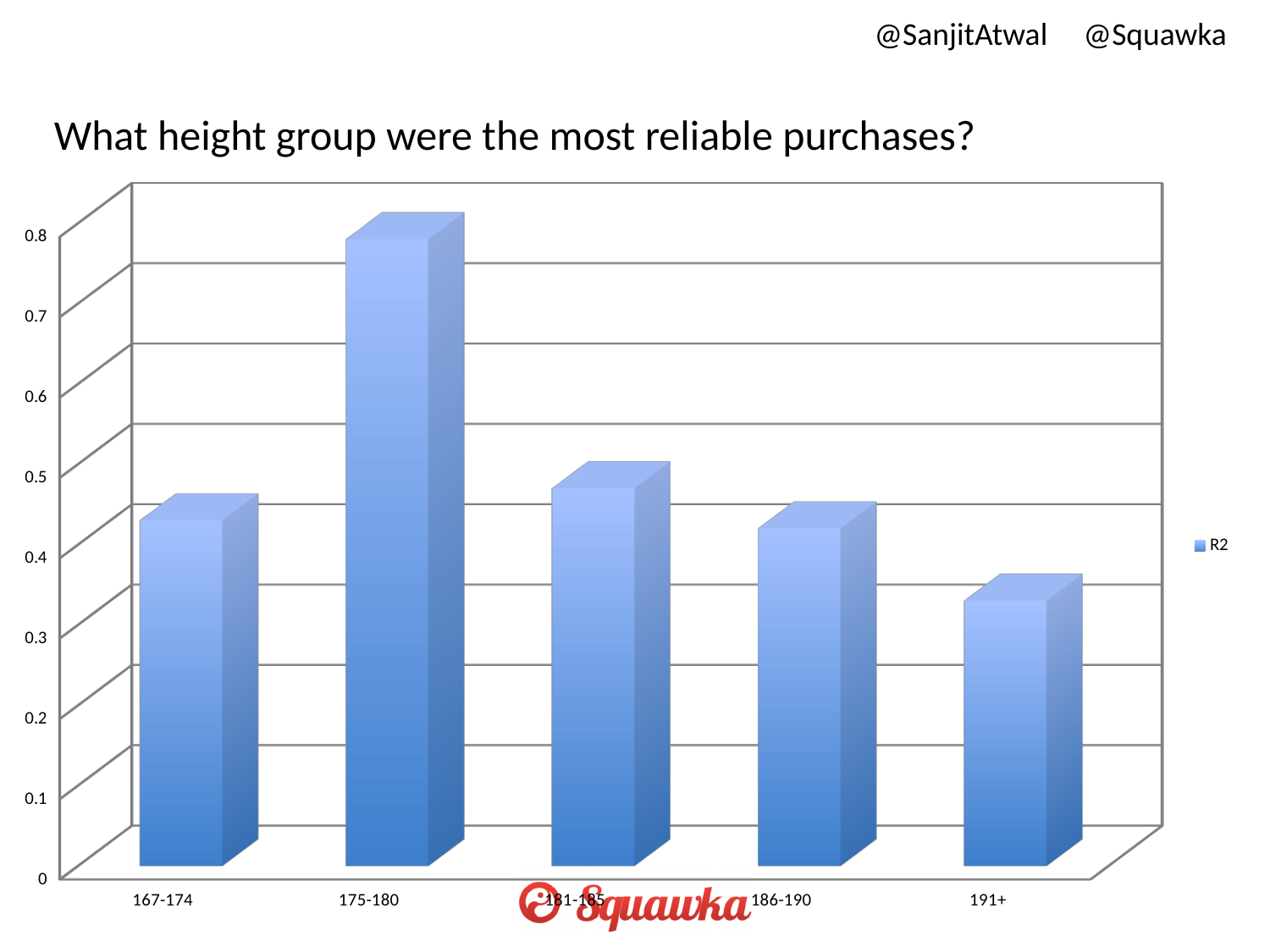
How many series does the legend list? 1 How many height groups are shown on the x axis? 5 What series name is shown in the legend? R2 Is the value for 175-180 greater or less than 0.7? greater Which height group has the highest bar? 175-180 What is the title of the chart? What height group were the most reliable purchases? Which height group has the lowest bar? 191+ Which is larger, the value for 181-185 or the value for 191+? 181-185 Is the value for 191+ greater or less than 0.4? less What kind of chart is shown on the slide? bar chart Is the value for 186-190 greater or less than 0.5? less